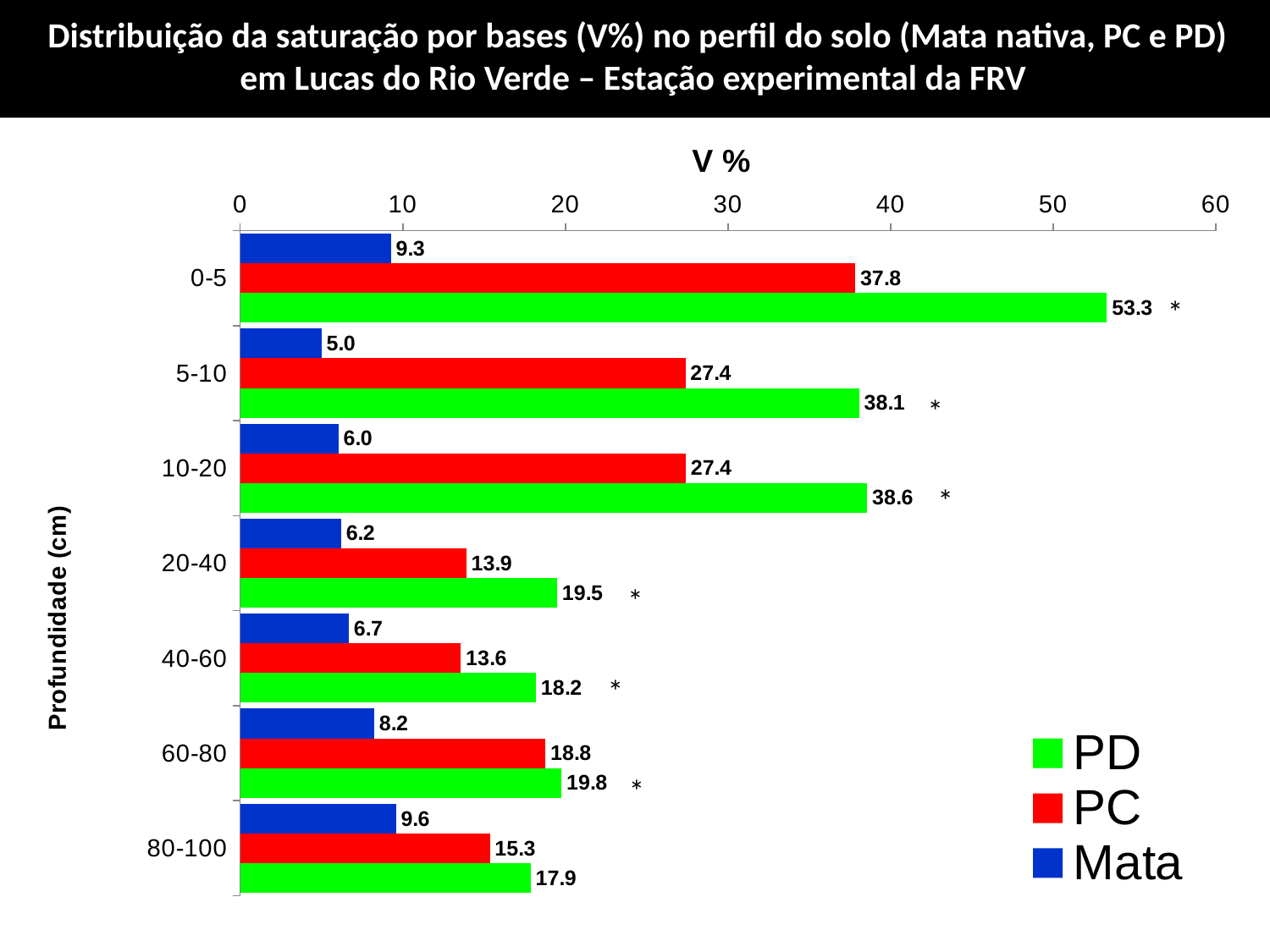
What is the V% value for PD at the 0-5 cm depth? 53.3 How many depth categories are shown on the chart? 7 How many series does the legend list? 3 What is the difference between the PD and PC values at the 0-5 cm depth? 15.5 What colour represents the Mata series in the chart? blue Which depth has the lowest V% value for Mata? 5-10 What kind of chart is shown on the slide? bar chart What is the V% value for Mata at the 5-10 cm depth? 5.0 Which depth has the highest V% value for PD? 0-5 What is the V% value for PC at the 80-100 cm depth? 15.3 Which is larger at the 60-80 cm depth, the PC value or the Mata value? PC Is the PD value at the 10-20 cm depth greater or less than 30? greater